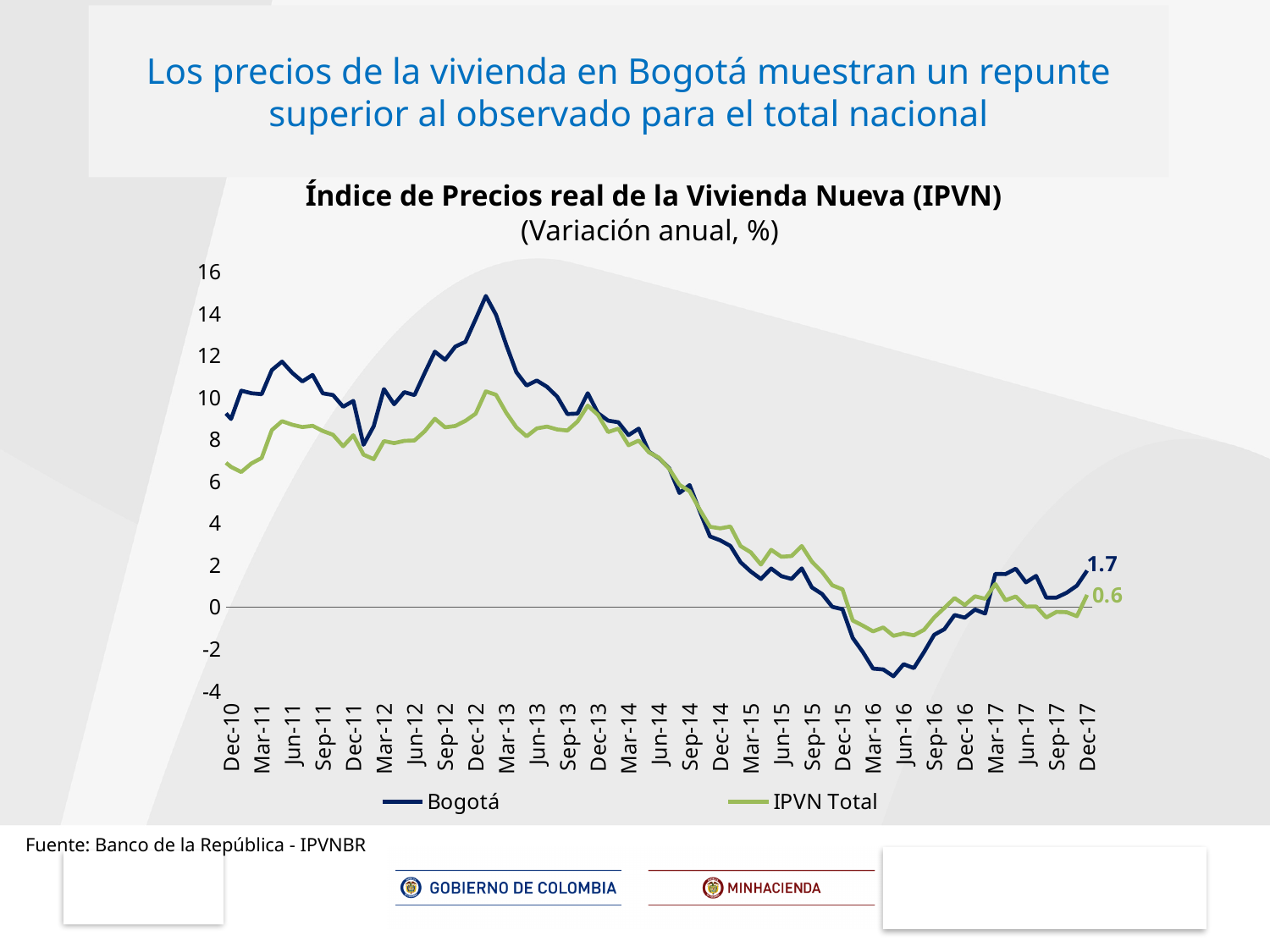
What is the title of the chart? Índice de Precios real de la Vivienda Nueva (IPVN) What is the value of the Bogotá series at Dec-17? 1.7 What is the value of the IPVN Total series at Dec-17? 0.6 What is the difference between the Bogotá and IPVN Total values at Dec-17? 1.1 What kind of chart is shown on the slide? Line chart Does the Bogotá series rise or fall between Dec-12 and Jun-16? Fall Is the value for Bogotá at Jun-16 greater or less than -2? less Is the value for IPVN Total at Mar-16 greater or less than 0? less How many series does the legend list? 2 At Dec-17, which series has the larger value, Bogotá or IPVN Total? Bogotá Which series reaches the highest peak on the chart? Bogotá